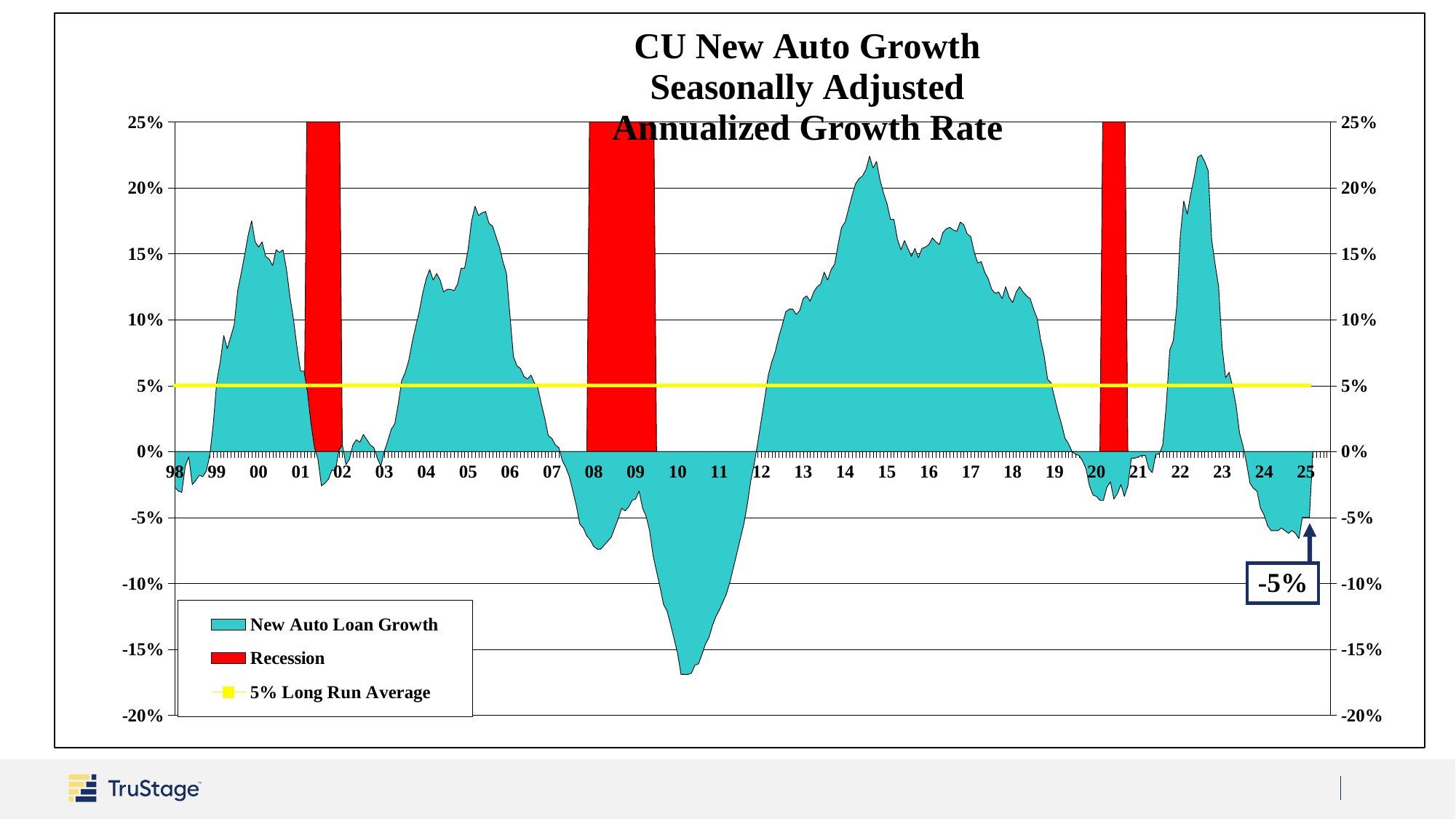
Does New Auto Loan Growth rise or fall from its 2022 peak to 2025? fall What value is the long run average line drawn at? 5% How many entries does the chart legend list? 3 Is the peak of New Auto Loan Growth around 2022 greater or less than 20%? greater Is the peak of New Auto Loan Growth around 2000 greater or less than 15%? greater Which is larger, New Auto Loan Growth in 2016 or in 2018? 2016 In which year does New Auto Loan Growth reach its lowest point? 2010 How many recession periods are shaded on the chart? 3 What is the title of the chart? CU New Auto Growth Seasonally Adjusted Annualized Growth Rate What kind of chart is shown on the slide? area chart Is the lowest value of New Auto Loan Growth around 2010 greater or less than -15%? less What value does the annotation give for the most recent point in 2025? -5%